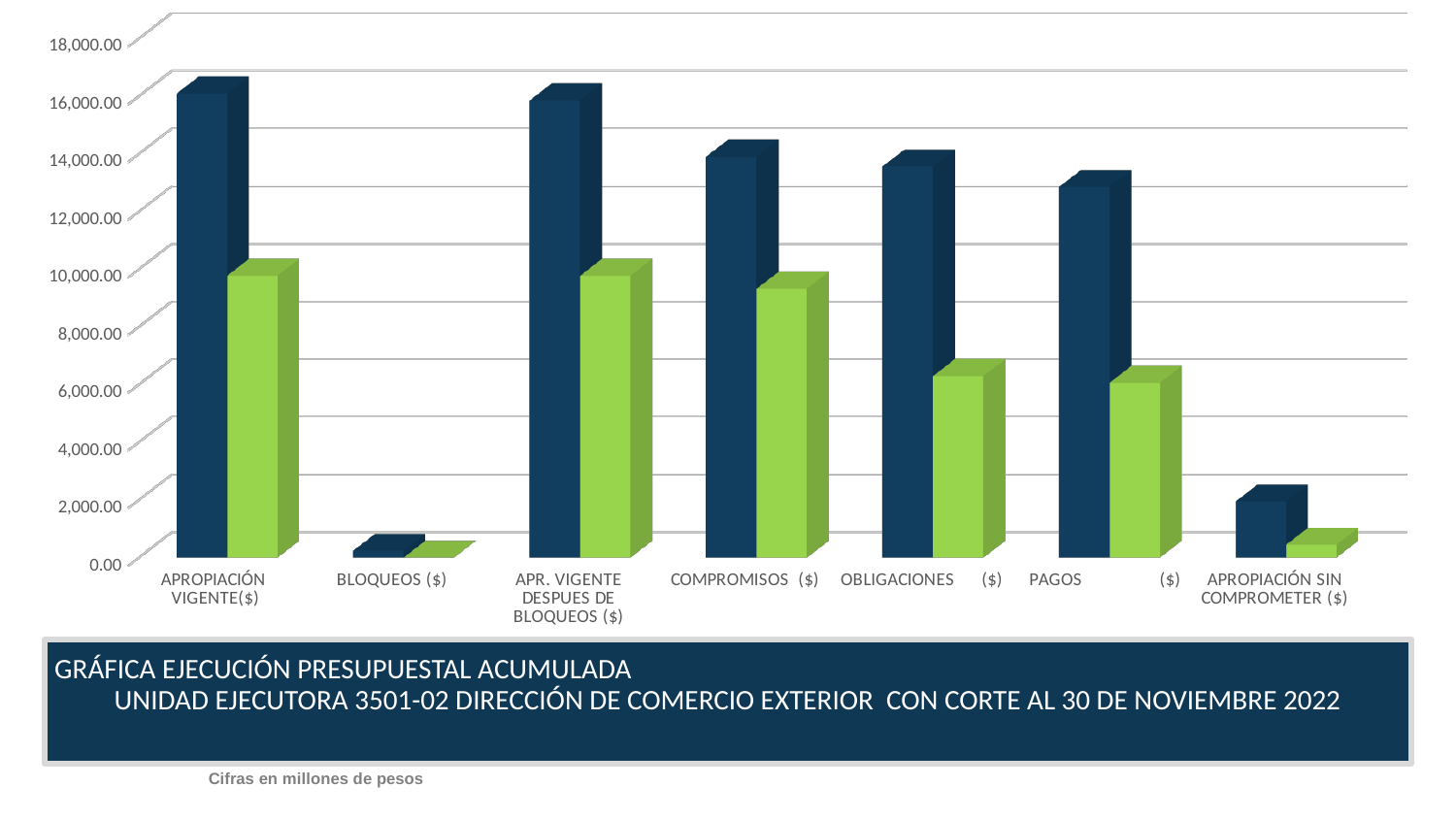
How many categories are shown on the x axis of the chart? 7 Is the dark blue bar for APROPIACIÓN SIN COMPROMETER ($) greater or less than 4,000.00? less Which category has the lowest green bar? BLOQUEOS ($) Is the green bar for OBLIGACIONES ($) greater or less than 8,000.00? less Is the dark blue bar for APROPIACIÓN VIGENTE($) greater or less than 14,000.00? greater What kind of chart is shown on the slide? bar chart Which is larger, the dark blue bar for COMPROMISOS ($) or the dark blue bar for PAGOS ($)? COMPROMISOS ($) According to the note below the chart, in what units are the figures expressed? Cifras en millones de pesos Which category has the lowest dark blue bar? BLOQUEOS ($) Which is larger, the green bar for COMPROMISOS ($) or the green bar for OBLIGACIONES ($)? COMPROMISOS ($)